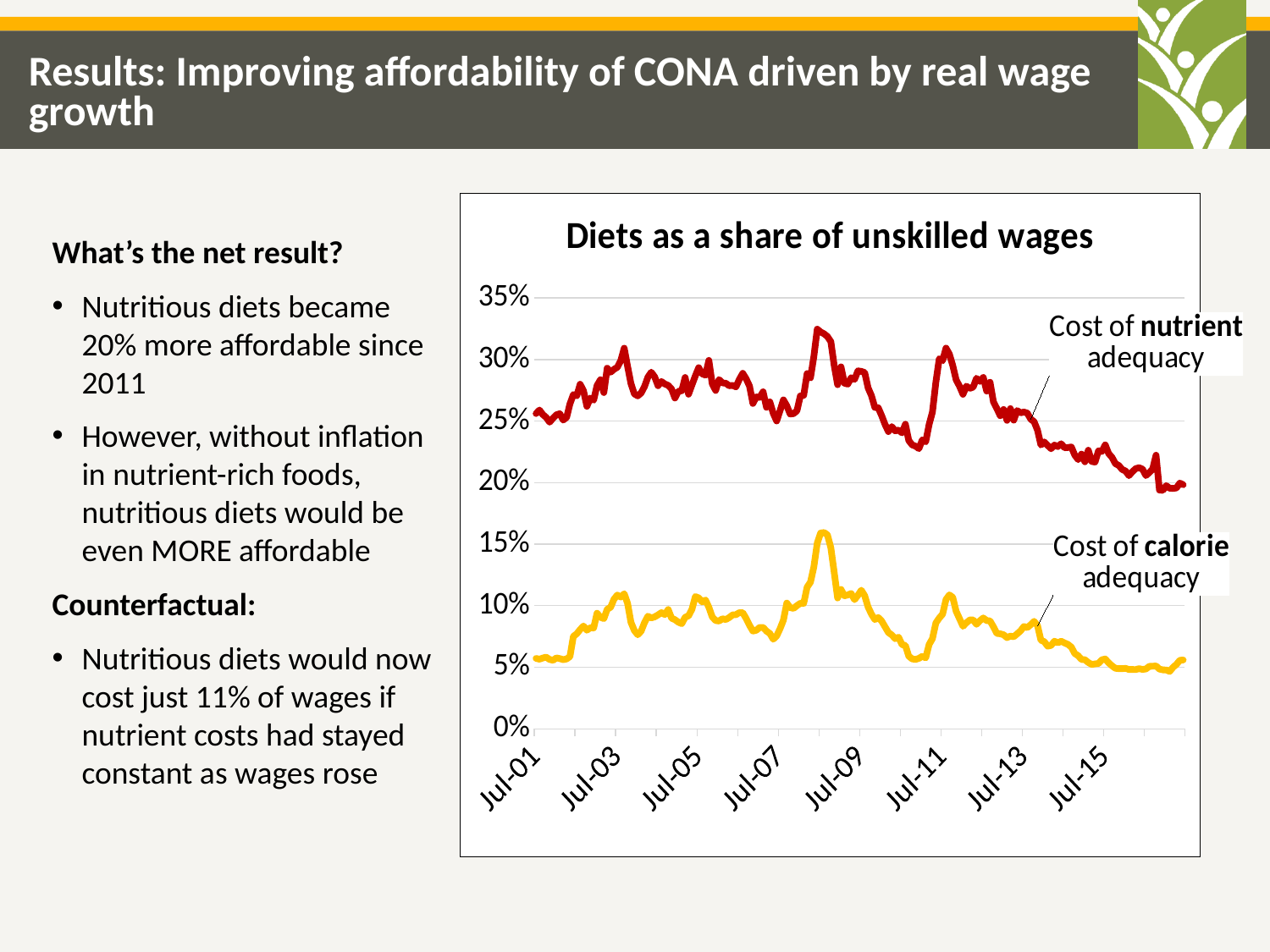
What kind of chart is shown on the slide? line chart Is the value for Cost of nutrient adequacy at Jul-15 greater or less than 25%? less Around which x-axis label does the Cost of calorie adequacy series reach its highest point? Jul-09 Is the peak value of Cost of calorie adequacy around Jul-09 greater or less than 10%? greater Which series is plotted in red? Cost of nutrient adequacy How many series are plotted in the chart? 2 Which series is higher throughout the chart, Cost of nutrient adequacy or Cost of calorie adequacy? Cost of nutrient adequacy What is the title of the chart? Diets as a share of unskilled wages Is the value for Cost of nutrient adequacy at Jul-01 greater or less than 20%? greater Does the Cost of nutrient adequacy series rise or fall between Jul-11 and Jul-15? fall How many labelled tick marks are shown on the x axis? 8